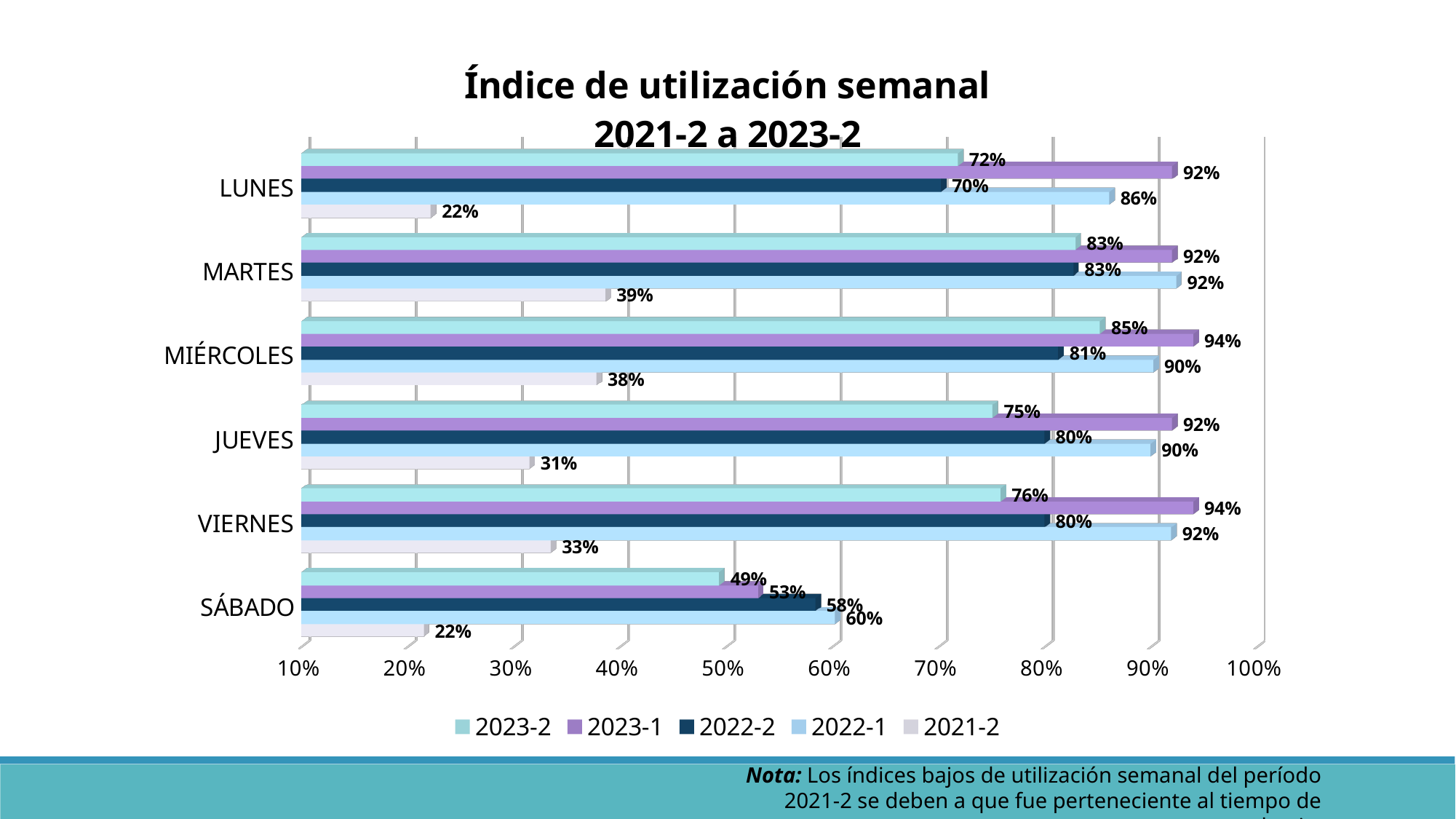
What is the title of the chart? Índice de utilización semanal 2021-2 a 2023-2 How many days are shown on the vertical axis? 6 What kind of chart is shown on the slide? Bar chart What is the value for LUNES in the 2023-1 series? 92% Which day has the highest value in the 2021-2 series? MARTES What is the value for JUEVES in the 2023-2 series? 75% What is the difference between the 2023-1 and 2023-2 values for VIERNES? 18% For SÁBADO, which is larger: the 2022-2 value or the 2023-1 value? 2022-2 What is the value for MIÉRCOLES in the 2021-2 series? 38% Which day has the lowest value in the 2023-2 series? SÁBADO How many series does the legend list? 5 What is the value for SÁBADO in the 2022-1 series? 60%